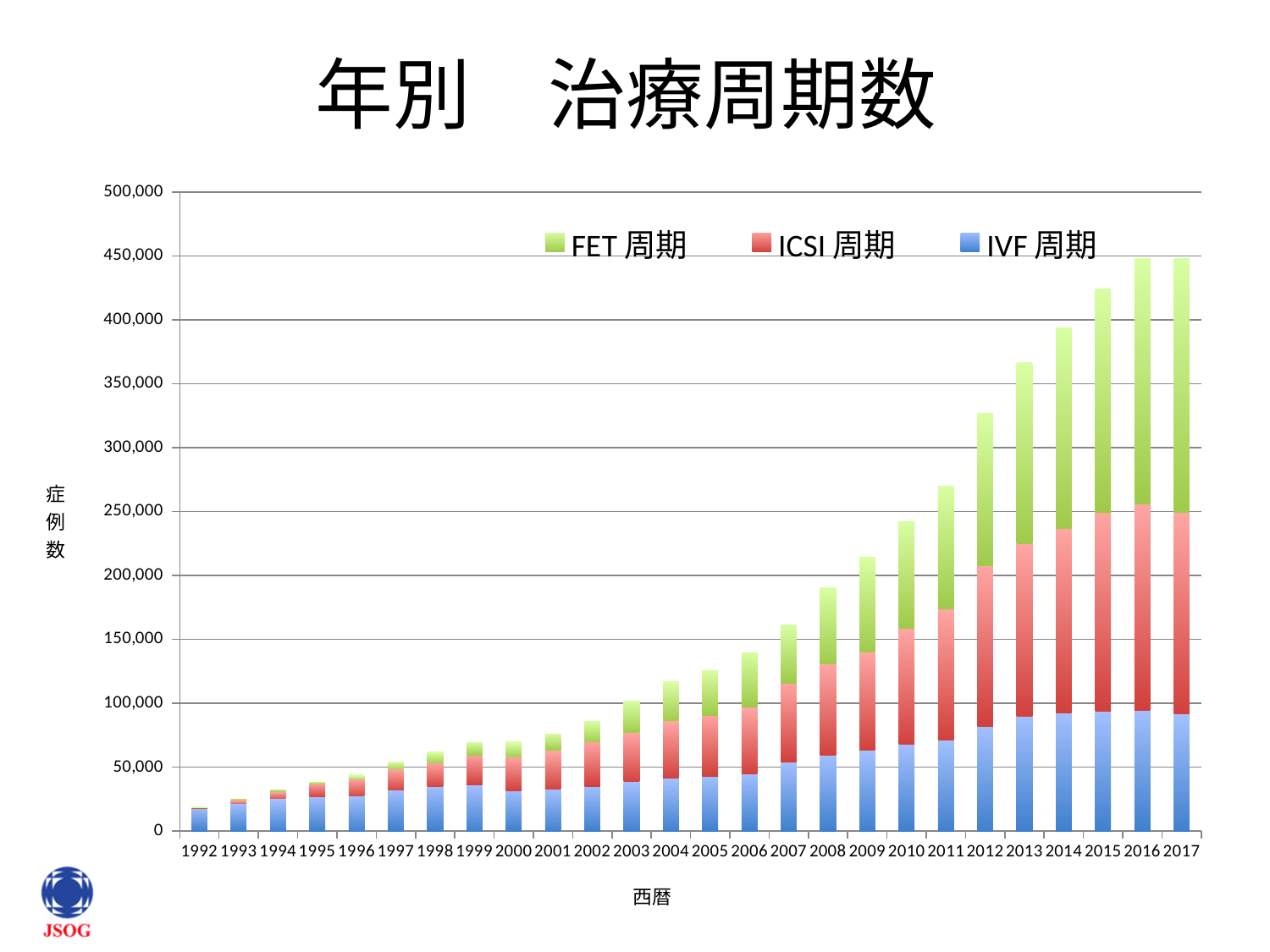
Do the total treatment cycles generally rise or fall from 1992 to 2017? Rise What is the title of the chart? 年別 治療周期数 How many years are shown along the x axis? 26 Which series is shown in green in the legend? FET 周期 Which year has the larger total number of cycles, 2011 or 2013? 2013 How many series does the legend list? 3 Is the total bar height for 2012 greater or less than 300,000? greater What kind of chart is shown on the slide? Stacked bar chart Which year has the lowest total number of treatment cycles? 1992 Is the total bar height for 2005 greater or less than 150,000? less Is the total bar height for 2017 greater or less than 400,000? greater